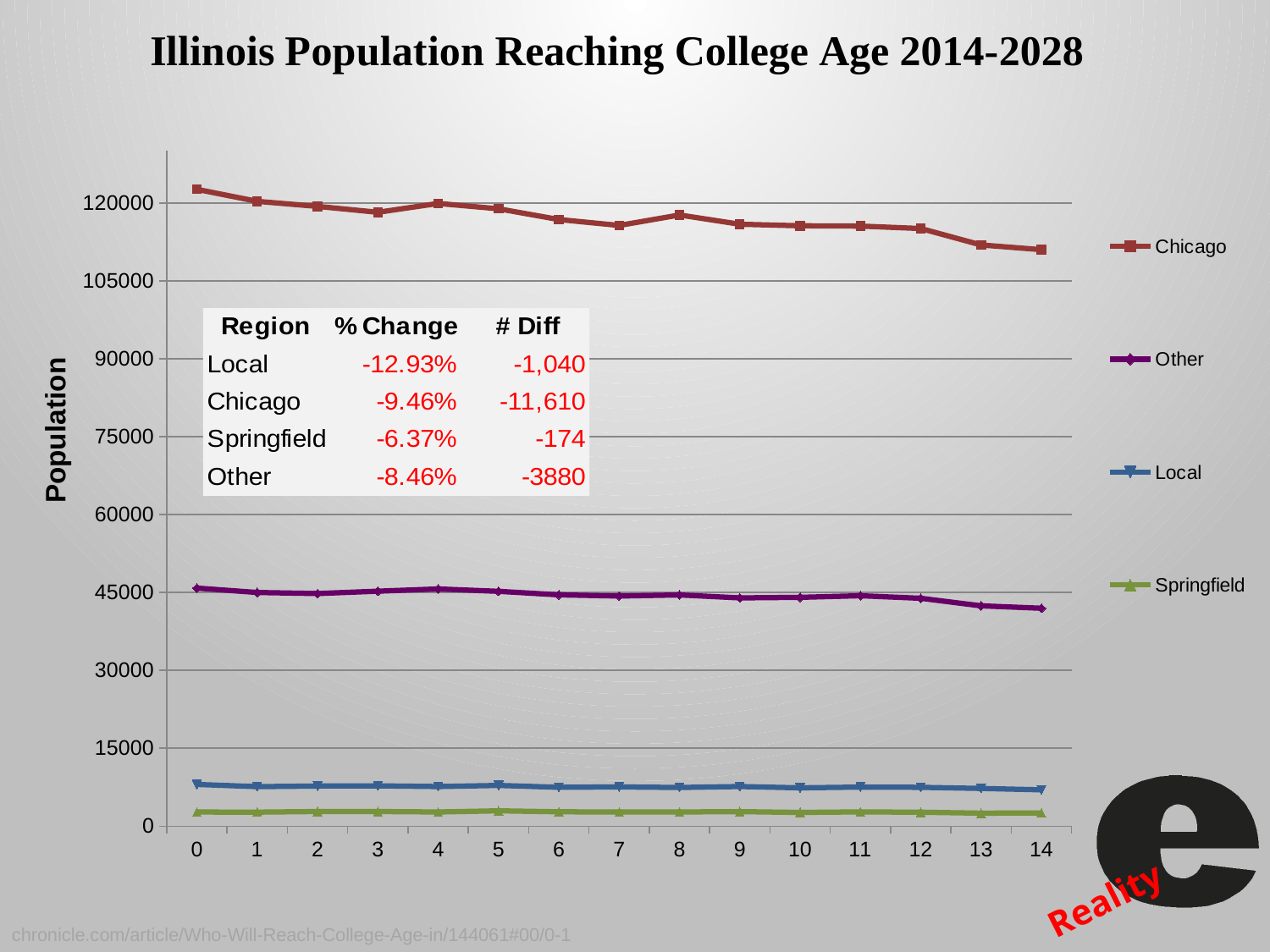
Which series has the highest values across the chart? Chicago At x = 0, which is larger, Local or Springfield? Local Is the value for Chicago at x = 14 greater or less than 120000? less What is the title of the chart? Illinois Population Reaching College Age 2014-2028 What kind of chart is shown on the slide? line chart How many series does the legend list? 4 Does the Chicago line rise or fall from x = 0 to x = 14? fall Is the value for Other at x = 14 greater or less than 45000? less How many points are plotted along the x axis for each series? 15 Is the value for Chicago at x = 0 greater or less than 120000? greater Which series has the lowest values across the chart? Springfield According to the table on the chart, what is the % Change for Local? -12.93%